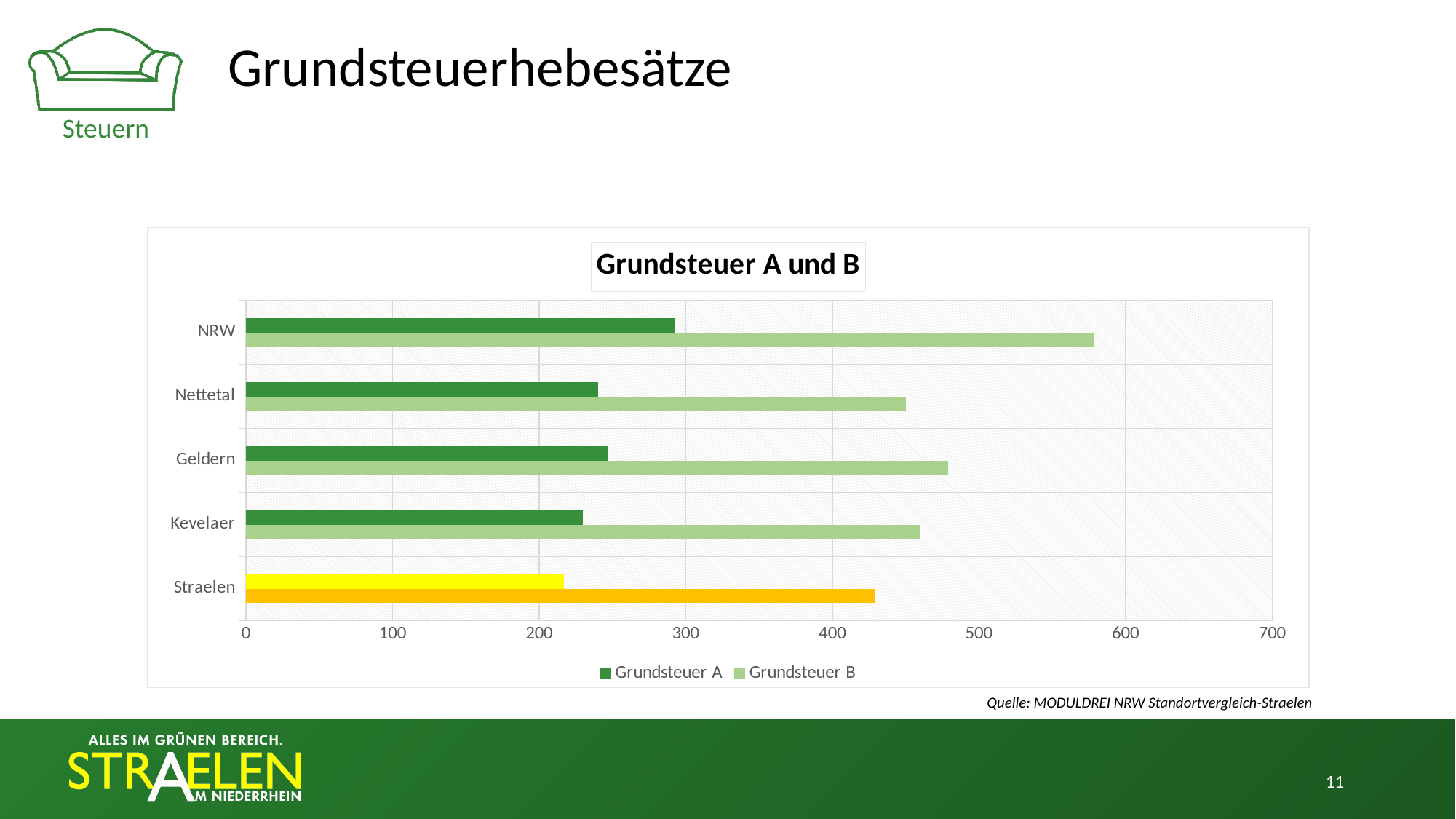
Is the Grundsteuer A value for Nettetal greater or less than 300? less Which category has the highest Grundsteuer A value? NRW How many categories are shown on the vertical axis of the chart? 5 Which category's bars are highlighted in yellow and orange instead of green? Straelen Which category has the highest Grundsteuer B value? NRW Is the Grundsteuer B value for Straelen greater or less than 400? greater Which is larger, the Grundsteuer B value for Geldern or for Nettetal? Geldern Which category has the lowest Grundsteuer B value? Straelen How many series does the legend list? 2 What is the title of the chart? Grundsteuer A und B Is the Grundsteuer B value for NRW greater or less than 500? greater What type of chart is shown on the slide? bar chart